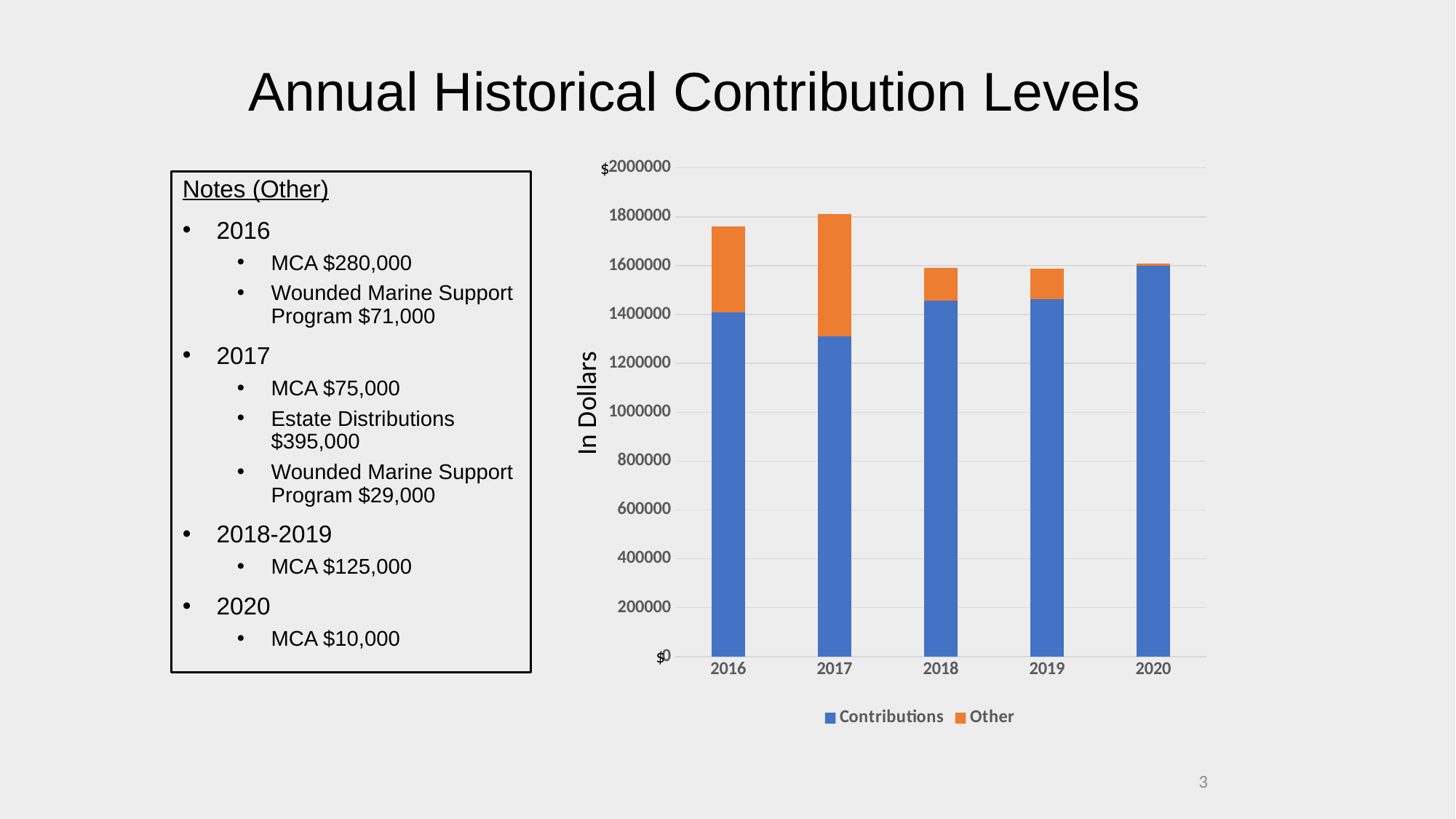
Which year has the smallest Other value? 2020 What is the title of the vertical axis of the chart? In Dollars Which year has the highest total bar (Contributions plus Other)? 2017 Which year has the lowest Contributions value? 2017 How many years are shown on the x axis of the chart? 5 Which year has the largest Other value? 2017 Is the Contributions value for 2019 greater or less than 1400000? greater Is the Contributions value for 2017 greater or less than 1400000? less How many series does the chart legend list? 2 What kind of chart is shown on the slide? Stacked bar chart Which year has the highest Contributions value? 2020 Which is larger, the Other value for 2016 or the Other value for 2018? 2016